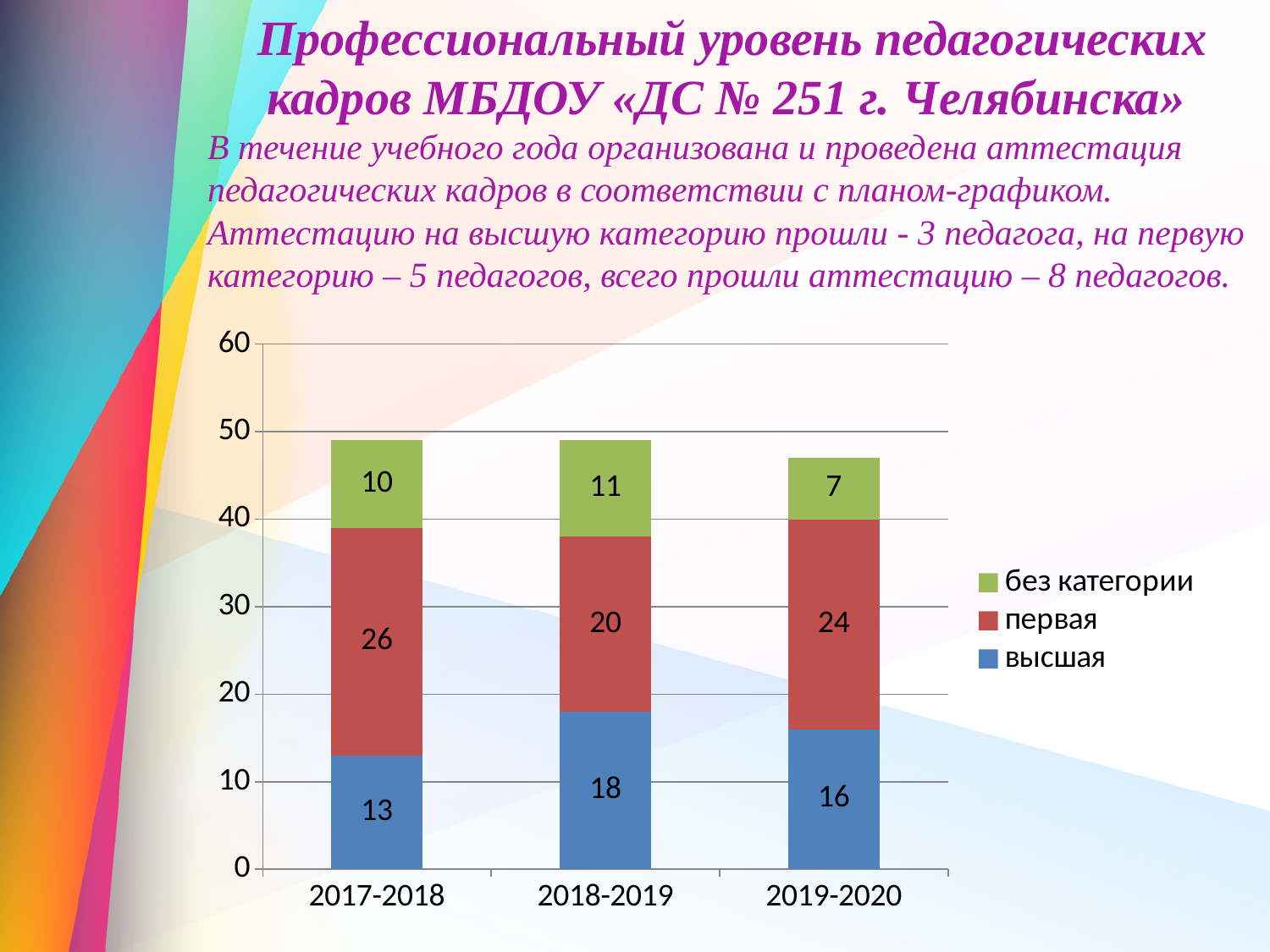
What is the total of the stacked bar for 2019-2020? 47 What is the value for "высшая" in 2018-2019? 18 In which year is the value for "первая" the lowest? 2018-2019 What is the value for "без категории" in 2019-2020? 7 How many series does the legend list? 3 What kind of chart is shown on the slide? stacked bar chart How many years are shown on the x axis? 3 What is the value for "первая" in 2017-2018? 26 Which is larger: "без категории" in 2017-2018 or in 2019-2020? 2017-2018 What is the total of the stacked bar for 2017-2018? 49 In which year is the value for "высшая" the highest? 2018-2019 What is the difference between the "первая" values for 2017-2018 and 2018-2019? 6